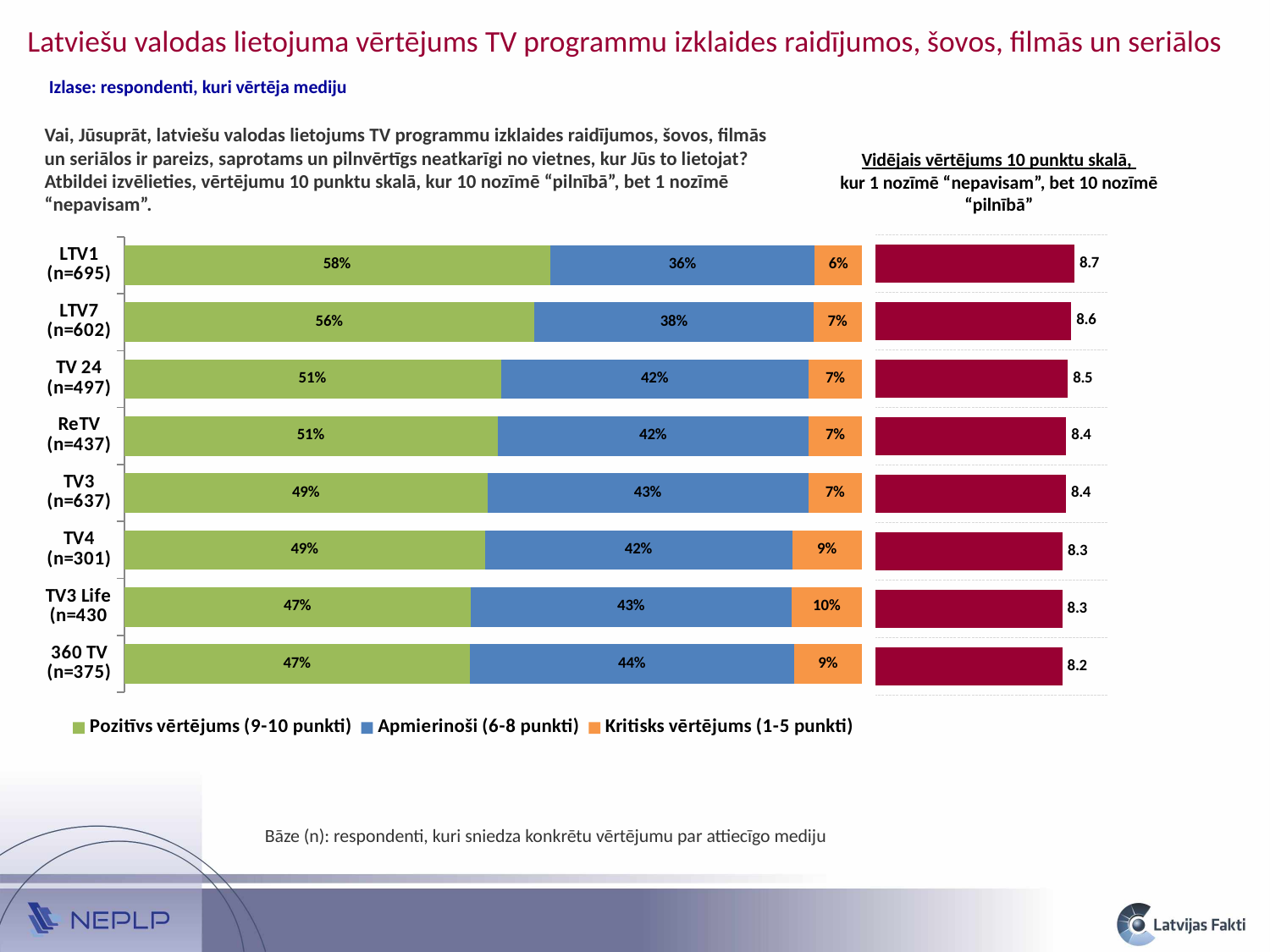
In the stacked bar chart on the left, how many series does the legend list? 3 In the stacked bar chart on the left, what is the value of "Kritisks vērtējums (1-5 punkti)" for TV3 Life (n=430)? 10% In the stacked bar chart on the left, what is the difference between the "Pozitīvs vērtējums (9-10 punkti)" values for LTV1 (n=695) and 360 TV (n=375)? 11% In the chart titled "Vidējais vērtējums 10 punktu skalā", which channel has the lowest average rating? 360 TV (n=375) In the stacked bar chart on the left, what is the value of "Pozitīvs vērtējums (9-10 punkti)" for LTV1 (n=695)? 58% What type of chart is the chart titled "Vidējais vērtējums 10 punktu skalā"? Bar chart In the chart titled "Vidējais vērtējums 10 punktu skalā", what is the average rating for TV 24 (n=497)? 8.5 In the stacked bar chart on the left, which channel has the highest "Pozitīvs vērtējums (9-10 punkti)" share? LTV1 (n=695) In the stacked bar chart on the left, which channel has the lowest "Kritisks vērtējums (1-5 punkti)" share? LTV1 (n=695) In the chart titled "Vidējais vērtējums 10 punktu skalā", what is the difference between the average ratings of LTV1 (n=695) and 360 TV (n=375)? 0.5 In the stacked bar chart on the left, what is the value of "Apmierinoši (6-8 punkti)" for 360 TV (n=375)? 44% In the stacked bar chart on the left, how many channels are shown? 8